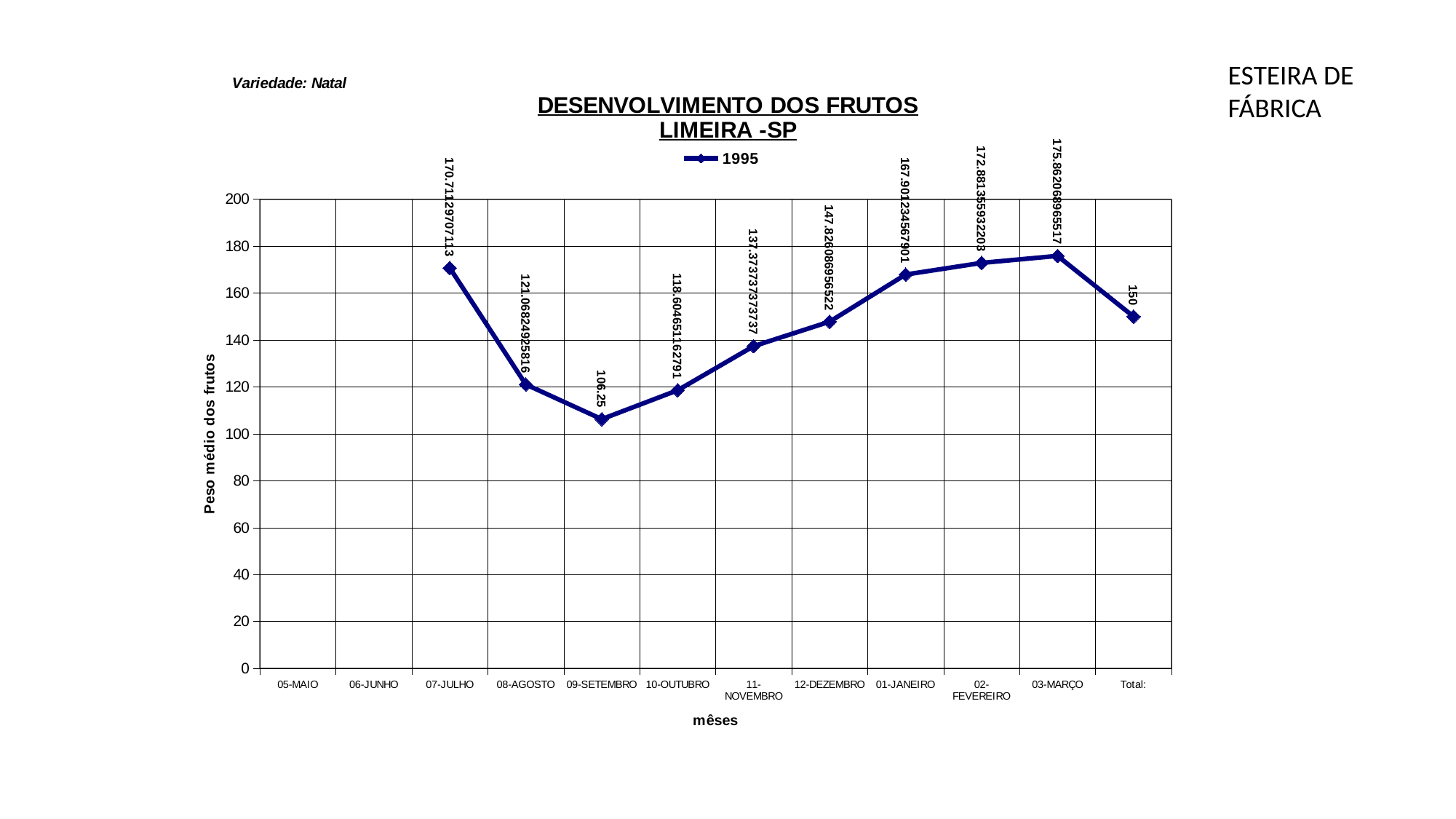
What kind of chart is shown on the slide? line chart What is the value plotted for the Total: category? 150 Which month has the highest plotted value? 03-MARÇO Is the value for 10-OUTUBRO greater or less than 120? less Is the value for 01-JANEIRO greater or less than 160? greater What series name appears in the legend? 1995 Which month has the lowest plotted value? 09-SETEMBRO Do the values rise or fall from 09-SETEMBRO to 03-MARÇO? rise What is the value plotted for 09-SETEMBRO? 106.25 How many series does the legend list? 1 What is the label of the y axis? Peso médio dos frutos Which has the larger value, 07-JULHO or 08-AGOSTO? 07-JULHO